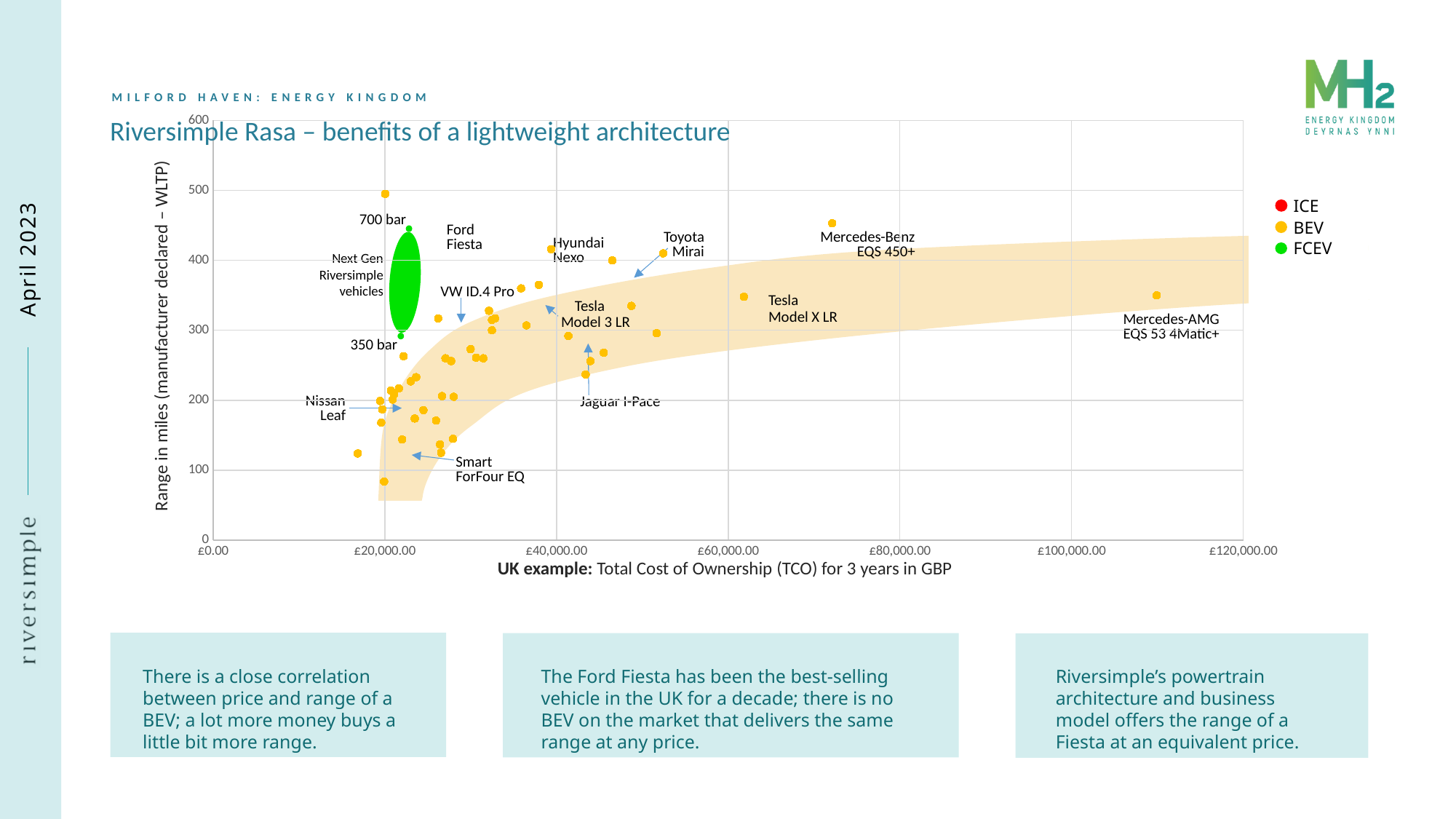
How many series does the chart legend list? 3 Is the range for the Tesla Model X LR greater or less than 400 miles? less Is the range for the Mercedes-Benz EQS 450+ greater or less than 400 miles? greater What is the label of the x axis of the chart? UK example: Total Cost of Ownership (TCO) for 3 years in GBP Is the range for the Smart ForFour EQ greater or less than 200 miles? less Which labelled vehicle has the highest total cost of ownership on the chart? Mercedes-AMG EQS 53 4Matic+ Which has the higher range, the Mercedes-Benz EQS 450+ or the Mercedes-AMG EQS 53 4Matic+? Mercedes-Benz EQS 450+ What kind of chart is shown on the slide? Scatter chart Which series in the legend is shown in green? FCEV